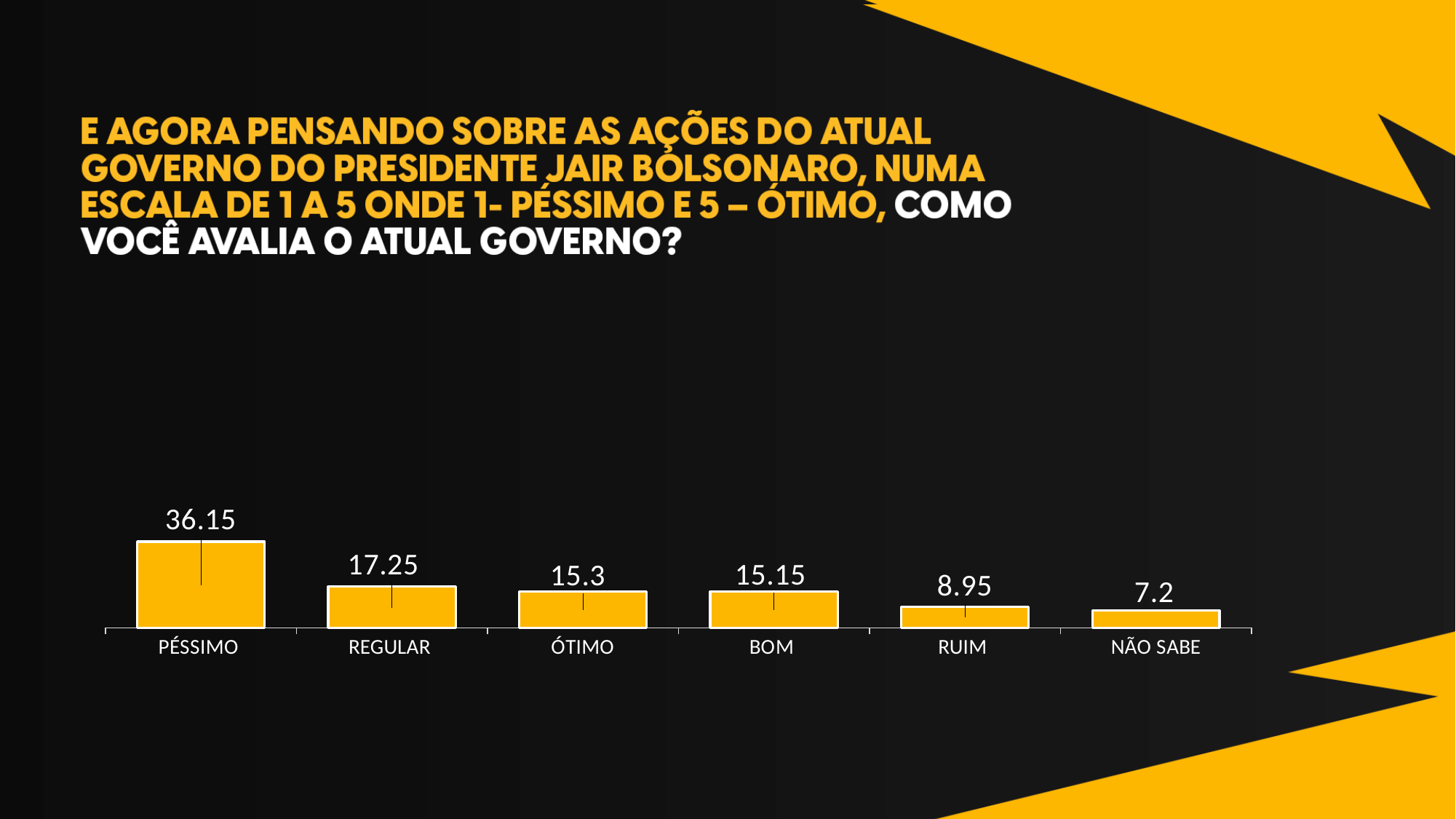
What is the difference between the values for PÉSSIMO and REGULAR? 18.9 What is the difference between the values for RUIM and NÃO SABE? 1.75 What is the value for REGULAR? 17.25 Which category has the highest value? PÉSSIMO What colour are the bars in the chart? Yellow How many categories are shown in the chart? 6 What kind of chart is shown on the slide? Bar chart What is the value for RUIM? 8.95 Which category has the lowest value? NÃO SABE Which is larger, the value for REGULAR or the value for RUIM? REGULAR What is the value for PÉSSIMO? 36.15 What is the value for NÃO SABE? 7.2